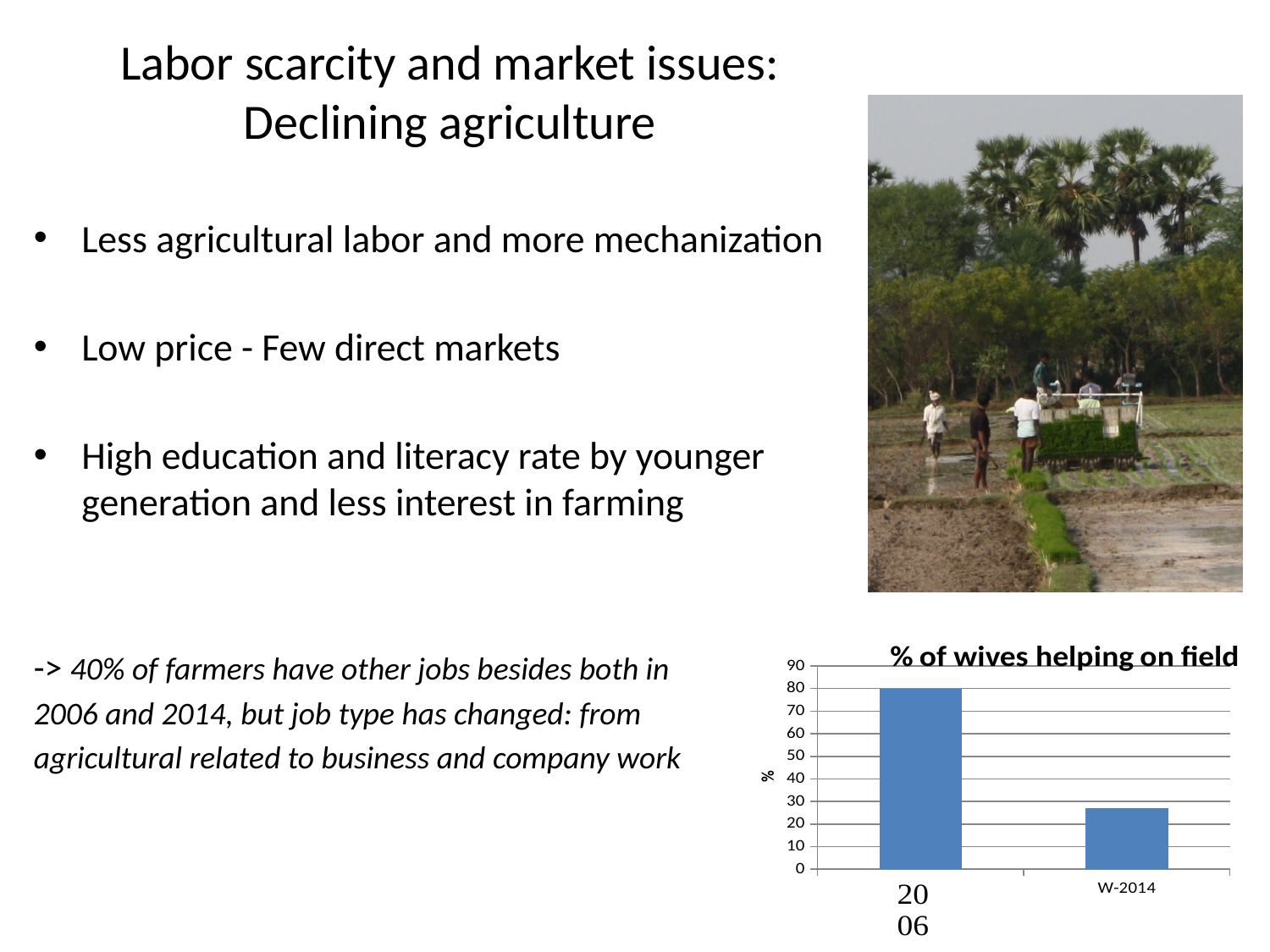
What is the value for 2006 in the chart? 80 How many categories are plotted in the chart? 2 Which category has the highest value in the chart? 2006 Which is larger, the value for 2006 or the value for W-2014? 2006 Which category has the lowest value in the chart? W-2014 Is the value for W-2014 greater or less than 20? greater Is the value for W-2014 greater or less than 30? less Is the value for 2006 greater or less than 70? greater Do the values rise or fall from 2006 to W-2014? fall What is the label on the vertical axis of the chart? % What kind of chart is shown on the slide? bar chart What is the title of the chart? % of wives helping on field